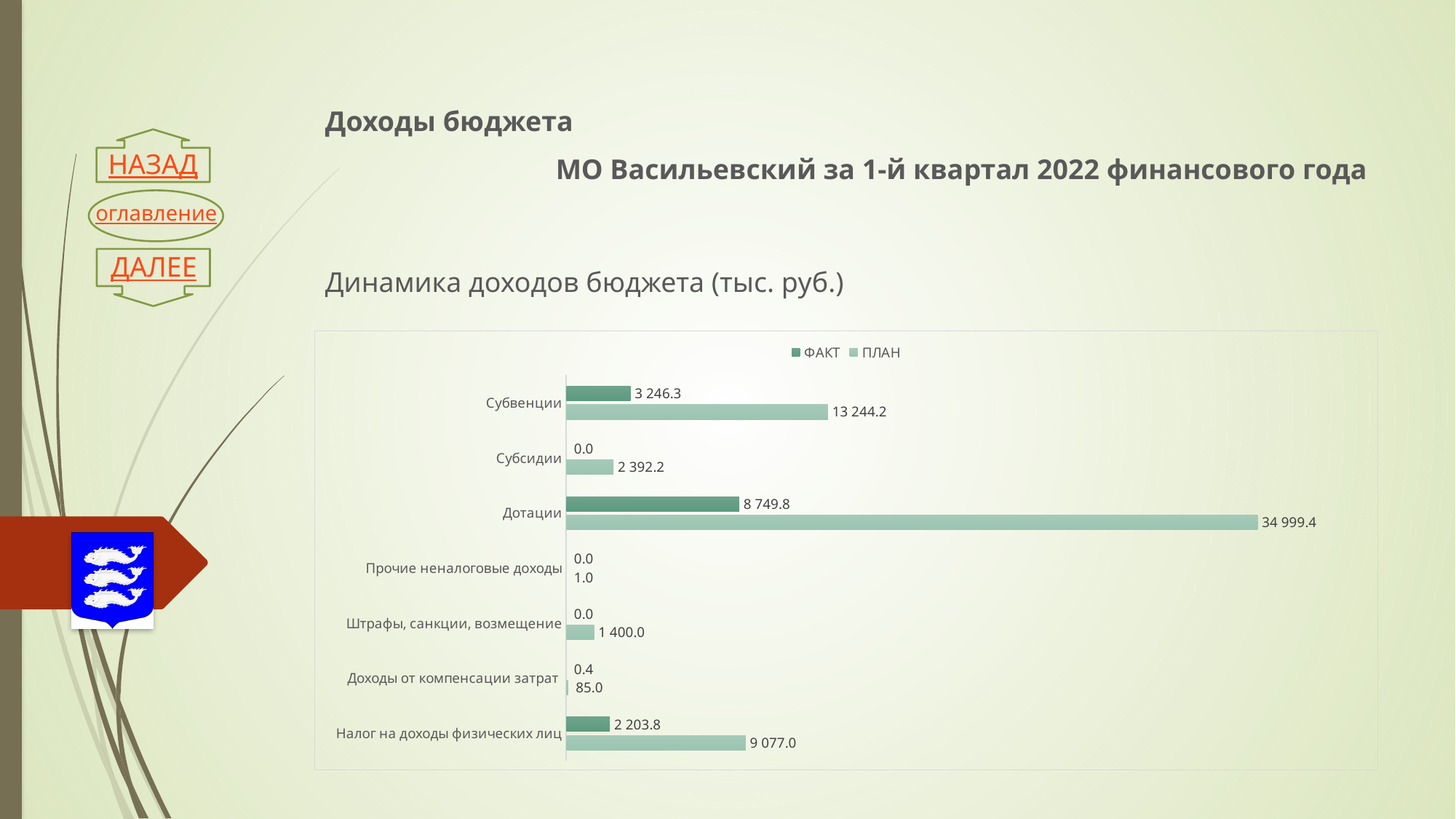
What is the difference between the ПЛАН and ФАКТ values for Дотации? 26 249.6 Which is larger, the ФАКТ value for Субвенции or the ФАКТ value for Налог на доходы физических лиц? Субвенции Which category has the highest ПЛАН value? Дотации How many series does the legend list? 2 What is the ПЛАН value for Дотации? 34 999.4 What are the two series named in the legend? ФАКТ and ПЛАН What is the ФАКТ value for Субвенции? 3 246.3 How many categories are shown on the chart? 7 What type of chart is shown on the slide? bar chart Which category has the lowest ПЛАН value? Прочие неналоговые доходы What is the ПЛАН value for Налог на доходы физических лиц? 9 077.0 What is the ФАКТ value for Доходы от компенсации затрат? 0.4